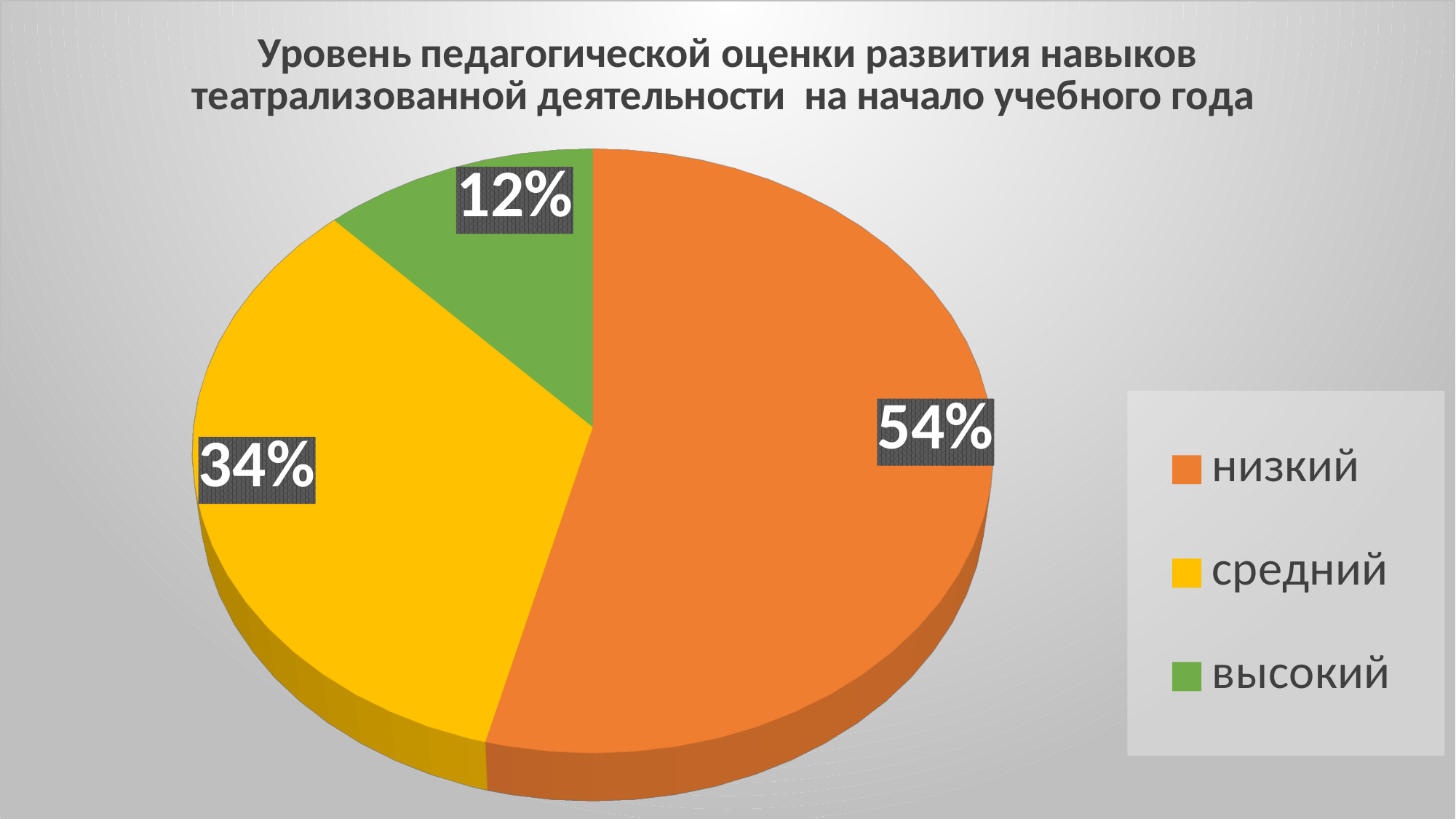
How many categories are shown in the pie chart? 3 Which legend entry is shown in green? высокий What share of the pie does the "средний" slice represent? 34% What is the difference in percentage points between the "низкий" and "средний" slices? 20 What kind of chart is shown on the slide? pie chart What is the difference in percentage points between the "средний" and "высокий" slices? 22 Which is larger, the "средний" slice or the "высокий" slice? средний What share of the pie does the "низкий" slice represent? 54% What colour is the "средний" slice in the pie chart? yellow Which category has the smallest slice of the pie? высокий Which category has the largest slice of the pie? низкий What share of the pie does the "высокий" slice represent? 12%